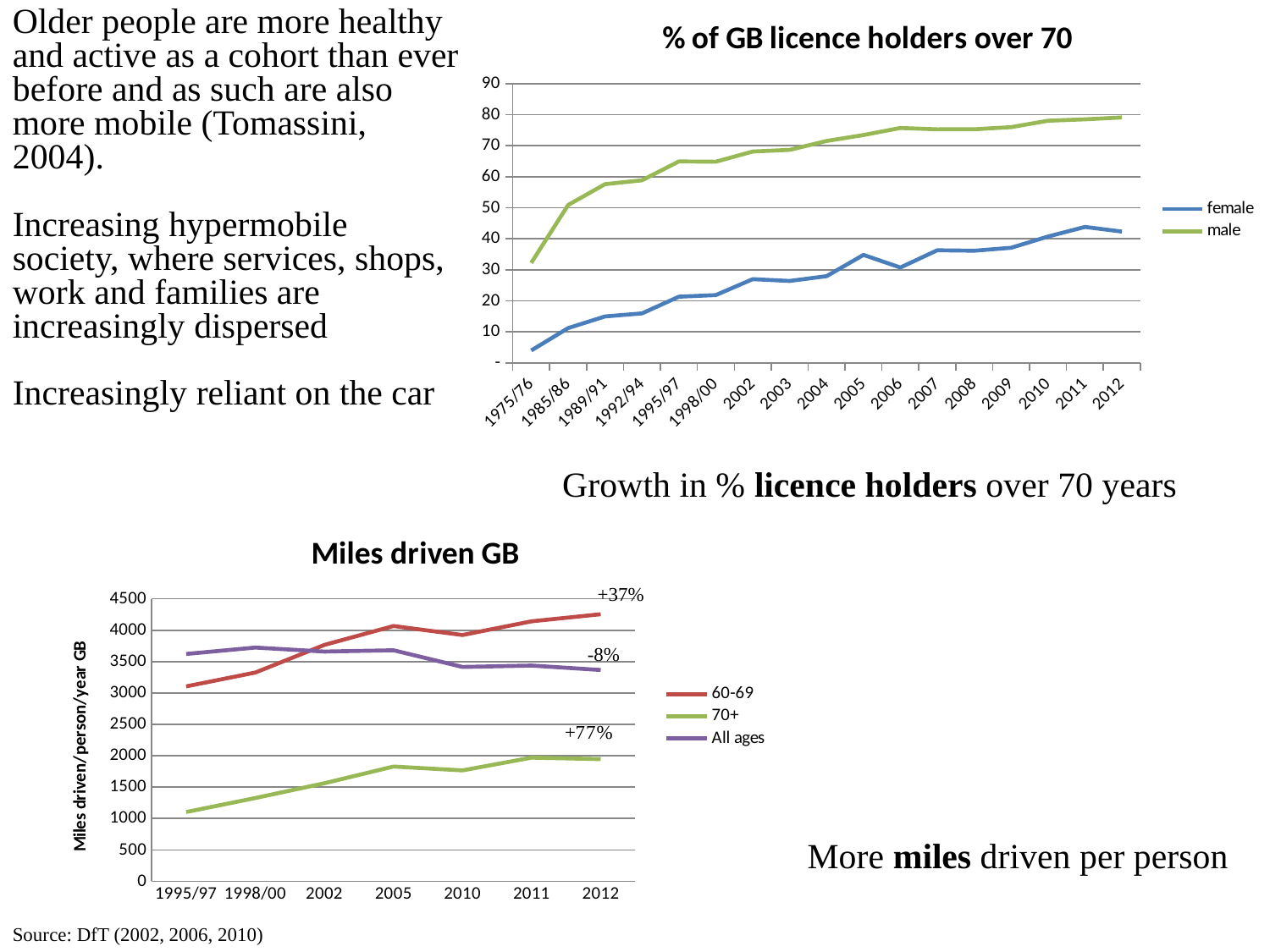
In the '% of GB licence holders over 70' chart, is the male value for 2012 greater or less than 70? greater In the 'Miles driven GB' chart, what percentage change is labelled next to the 70+ line? +77% How many series does the legend of the 'Miles driven GB' chart list? 3 How many series does the legend of the '% of GB licence holders over 70' chart list? 2 What is the y-axis label of the 'Miles driven GB' chart? Miles driven/person/year GB In the '% of GB licence holders over 70' chart, do the female values generally rise or fall from 1975/76 to 2012? rise In the 'Miles driven GB' chart, is the 70+ value for 1995/97 greater or less than 1500? less In the '% of GB licence holders over 70' chart, is the female value for 1975/76 greater or less than 10? less What type of chart is the '% of GB licence holders over 70' chart? line chart In the 'Miles driven GB' chart, what percentage change is labelled next to the All ages line? -8% In the '% of GB licence holders over 70' chart, which series is higher in 2012, male or female? male How many time periods are shown on the x axis of the '% of GB licence holders over 70' chart? 17